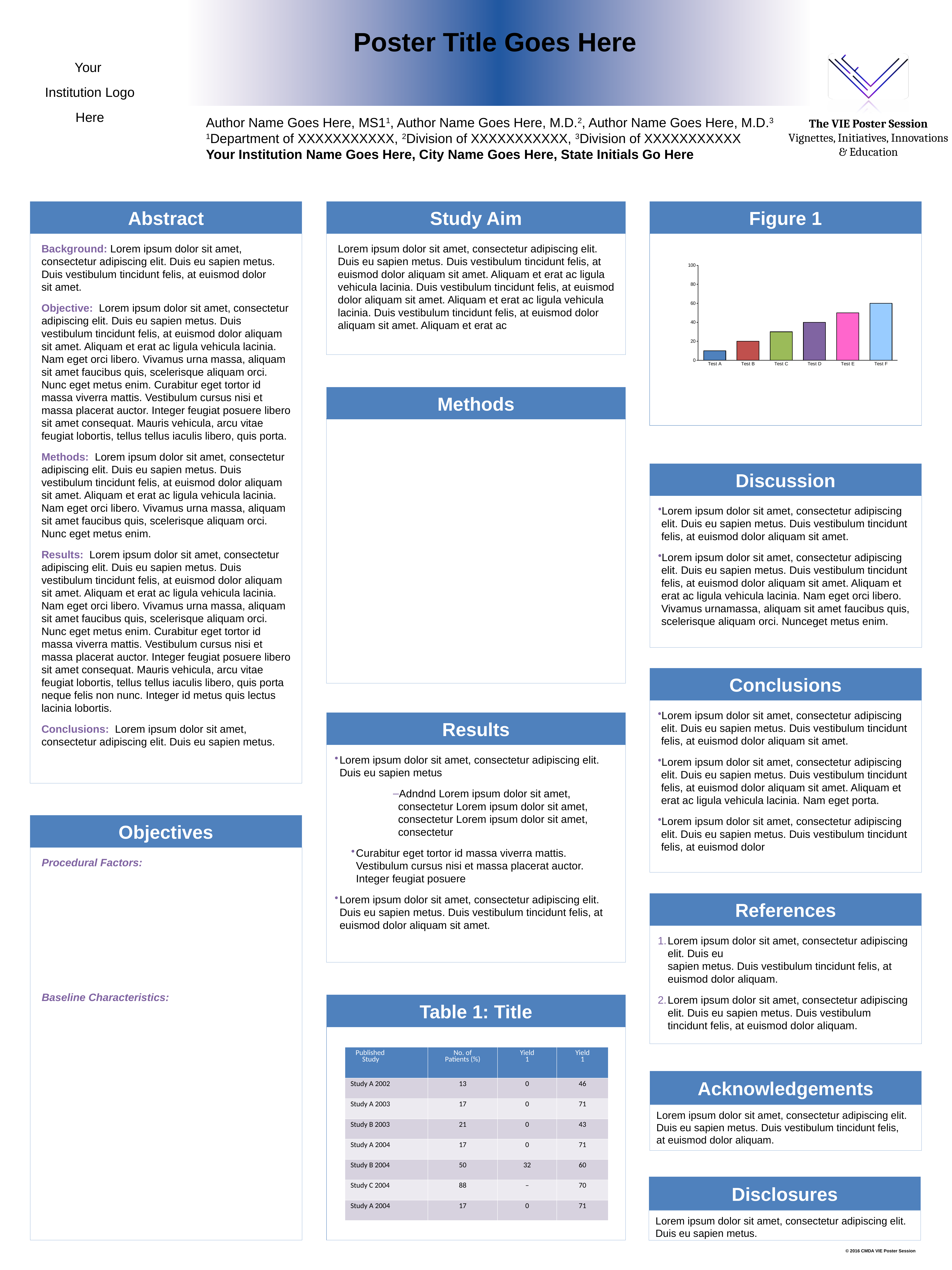
How many categories are plotted in the Figure 1 chart? 6 In the Figure 1 chart, is the value for Test A greater or less than 20? less What kind of chart is shown in Figure 1? bar chart Do the values in the Figure 1 chart rise or fall from Test A to Test F? rise What is the value for Test B in the Figure 1 chart? 20 In the Figure 1 chart, which is larger, the value for Test E or the value for Test B? Test E What is the value for Test F in the Figure 1 chart? 60 Which category has the highest value in the Figure 1 chart? Test F Which category has the lowest value in the Figure 1 chart? Test A In the Figure 1 chart, is the value for Test E greater or less than 40? greater In the Figure 1 chart, what is the difference between the values for Test F and Test B? 40 What is the value for Test D in the Figure 1 chart? 40